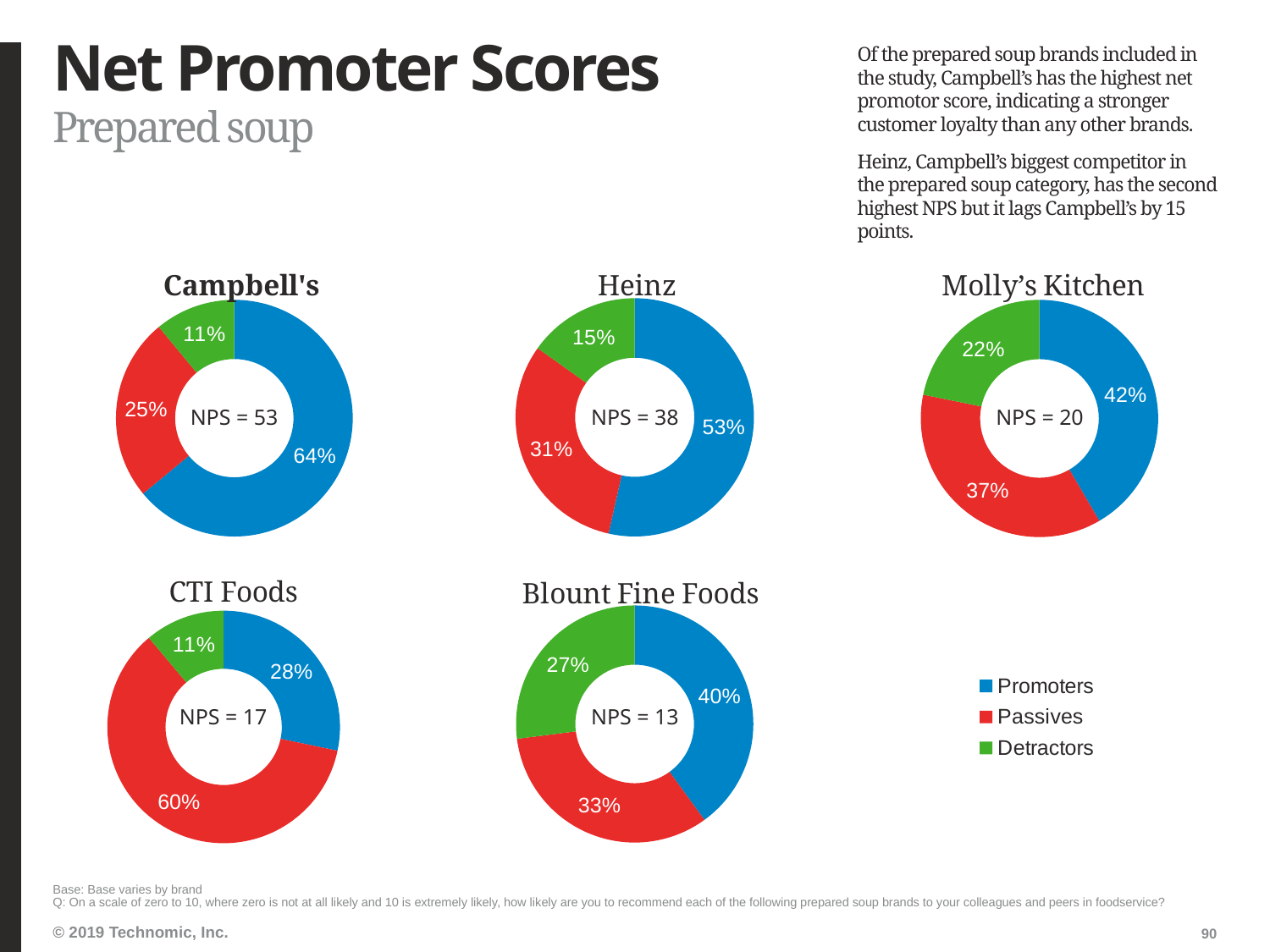
In the Blount Fine Foods chart, what percentage are Promoters? 40% In the Campbell's chart, which segment is the largest? Promoters In the Molly's Kitchen chart, which is larger, Promoters or Passives? Promoters How many series does the legend list? 3 In the Campbell's chart, what percentage are Promoters? 64% In the CTI Foods chart, which segment is the smallest? Detractors In the Heinz chart, what is the difference between the Promoters and Passives percentages? 22% What kind of chart is used for each brand on this slide? Doughnut chart In the Heinz chart, what percentage are Passives? 31% In the Molly's Kitchen chart, what percentage are Detractors? 22% In the Blount Fine Foods chart, what is the NPS shown in the centre? NPS = 13 In the CTI Foods chart, what percentage are Passives? 60%